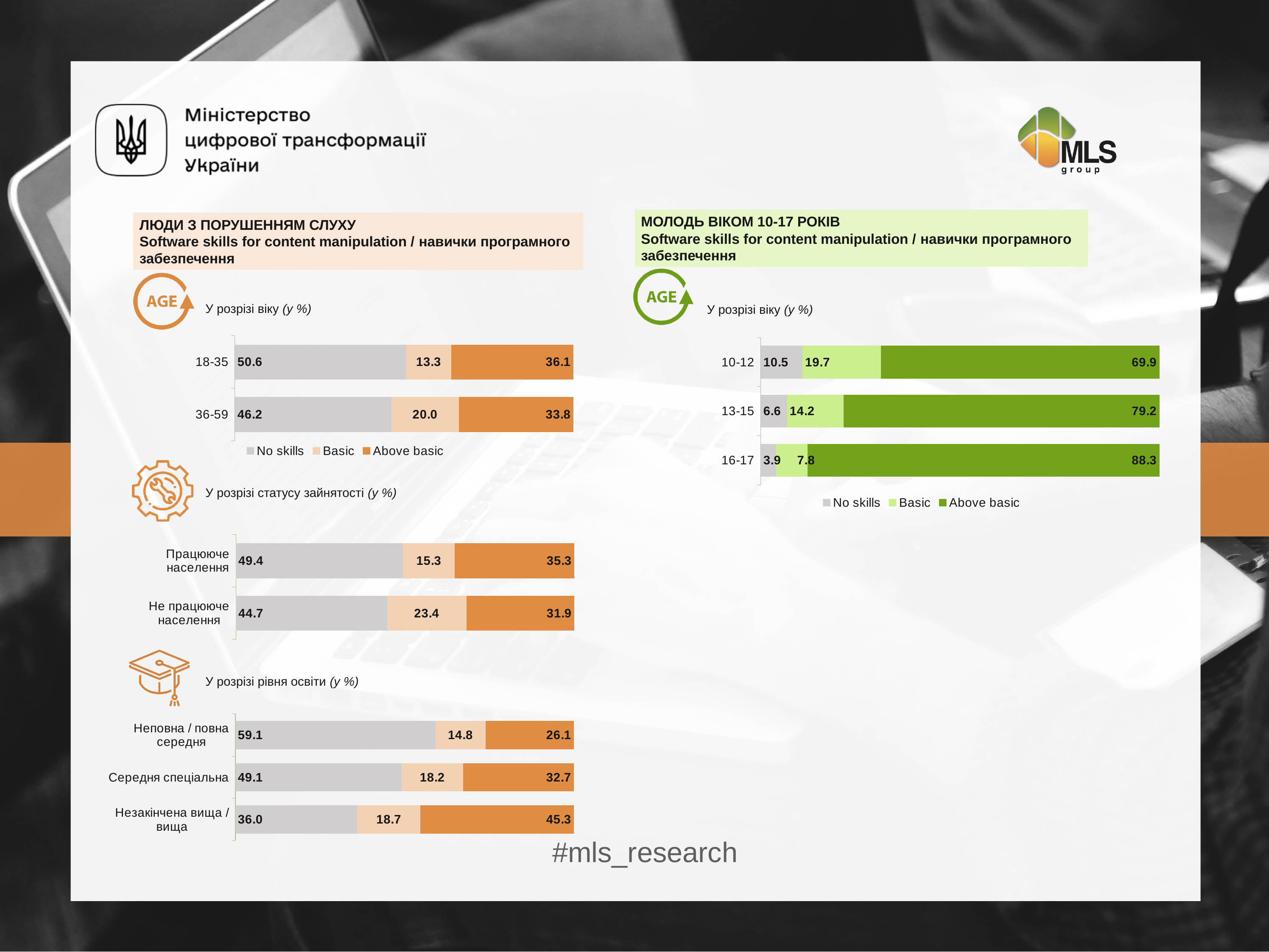
In the left-hand education level chart (У розрізі рівня освіти), which category has the highest 'No skills' value? Неповна / повна середня In the right-hand age chart for youth aged 10-17, which age group has the highest 'Above basic' value? 16-17 In the left-hand age chart for people with hearing impairment (ЛЮДИ З ПОРУШЕННЯМ СЛУХУ), what is the 'No skills' value for the 18-35 group? 50.6 In the right-hand age chart for youth aged 10-17 (МОЛОДЬ ВІКОМ 10-17 РОКІВ), what is the 'Above basic' value for the 16-17 group? 88.3 In the right-hand age chart for youth aged 10-17, which age group has the lowest 'No skills' value? 16-17 In the left-hand employment status chart (У розрізі статусу зайнятості), what is the 'Above basic' value for Працююче населення? 35.3 In the left-hand age chart for people with hearing impairment, what is the 'Basic' value for the 36-59 group? 20.0 How many categories are shown in the right-hand age chart for youth aged 10-17? 3 In the left-hand employment status chart, which group has the larger 'Basic' value, Працююче населення or Не працююче населення? Не працююче населення In the left-hand education level chart, what is the 'Above basic' value for Незакінчена вища / вища? 45.3 In the right-hand age chart for youth aged 10-17, what is the difference between the 'Above basic' values for 13-15 and 10-12? 9.3 How many series does the legend of the left-hand age chart for people with hearing impairment list? 3